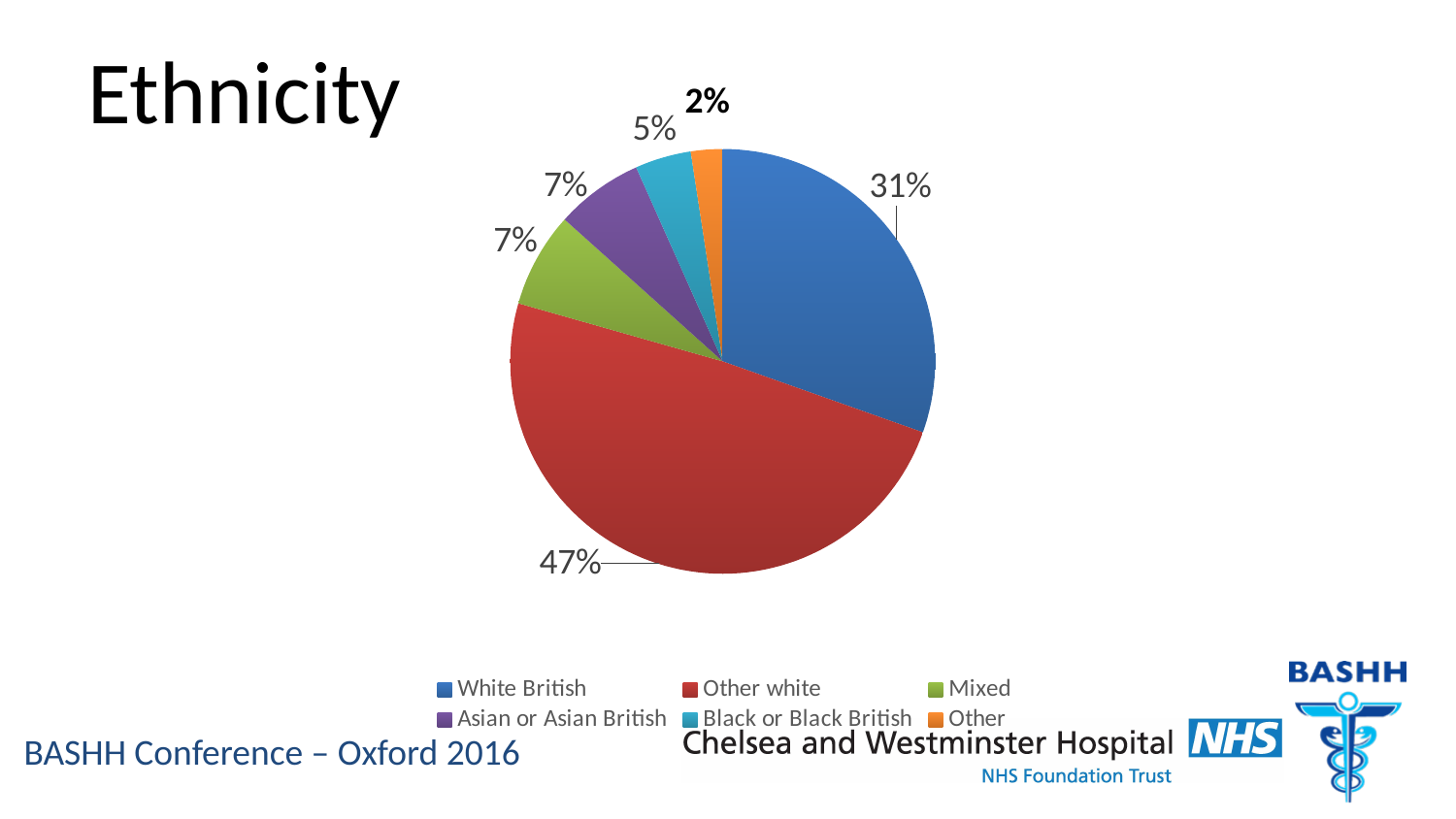
What share of the pie is Black or Black British? 5% Which ethnicity category has the smallest slice of the pie? Other What share of the pie is Other? 2% What is the difference in percentage points between Other white and White British? 16 What share of the pie is Other white? 47% What share of the pie is Mixed? 7% What kind of chart is shown on the slide? pie chart Which is larger, the share for White British or the share for Asian or Asian British? White British Which colour represents Other white in the pie chart? red Which ethnicity category has the largest slice of the pie? Other white What share of the pie is White British? 31% How many categories does the legend list? 6